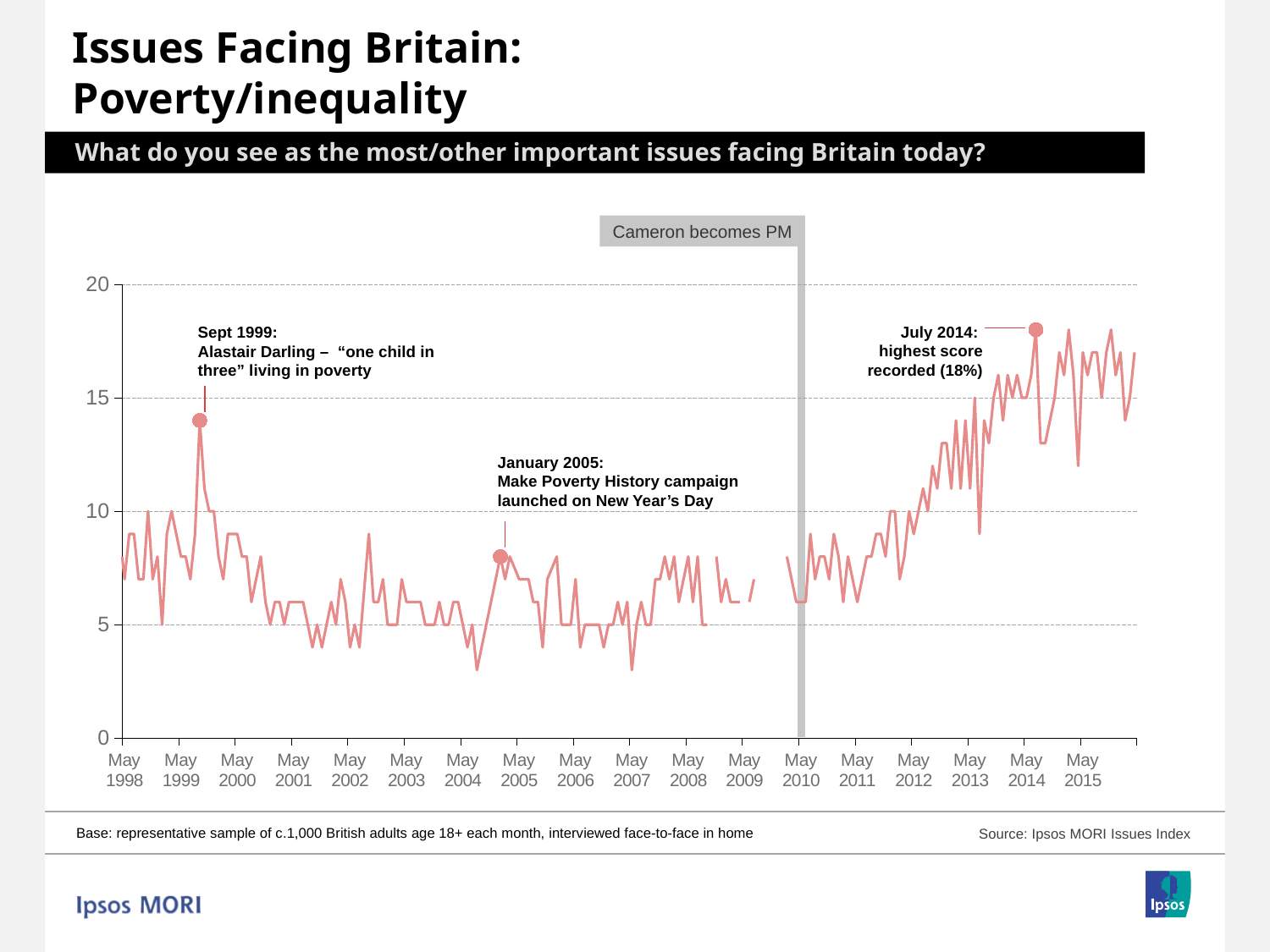
Is the value at the January 2005 point (Make Poverty History annotation) greater or less than 10? less In which month and year was the highest score recorded according to the chart annotation? July 2014 Is the value at the January 2005 point greater or less than 5? greater Is the value at the Sept 1999 peak greater or less than 15? less What is the highest score recorded, as noted in the July 2014 annotation? 18% What is the source of the data shown in the chart? Ipsos MORI Issues Index How many 'May' year labels are shown on the x axis? 18 Which is higher: the value at the Sept 1999 peak or the value at the January 2005 point? Sept 1999 peak What event is marked by the vertical grey bar at May 2010? Cameron becomes PM Between May 2010 and July 2014, do the values generally rise or fall? Rise What kind of chart is shown on the slide? Line chart